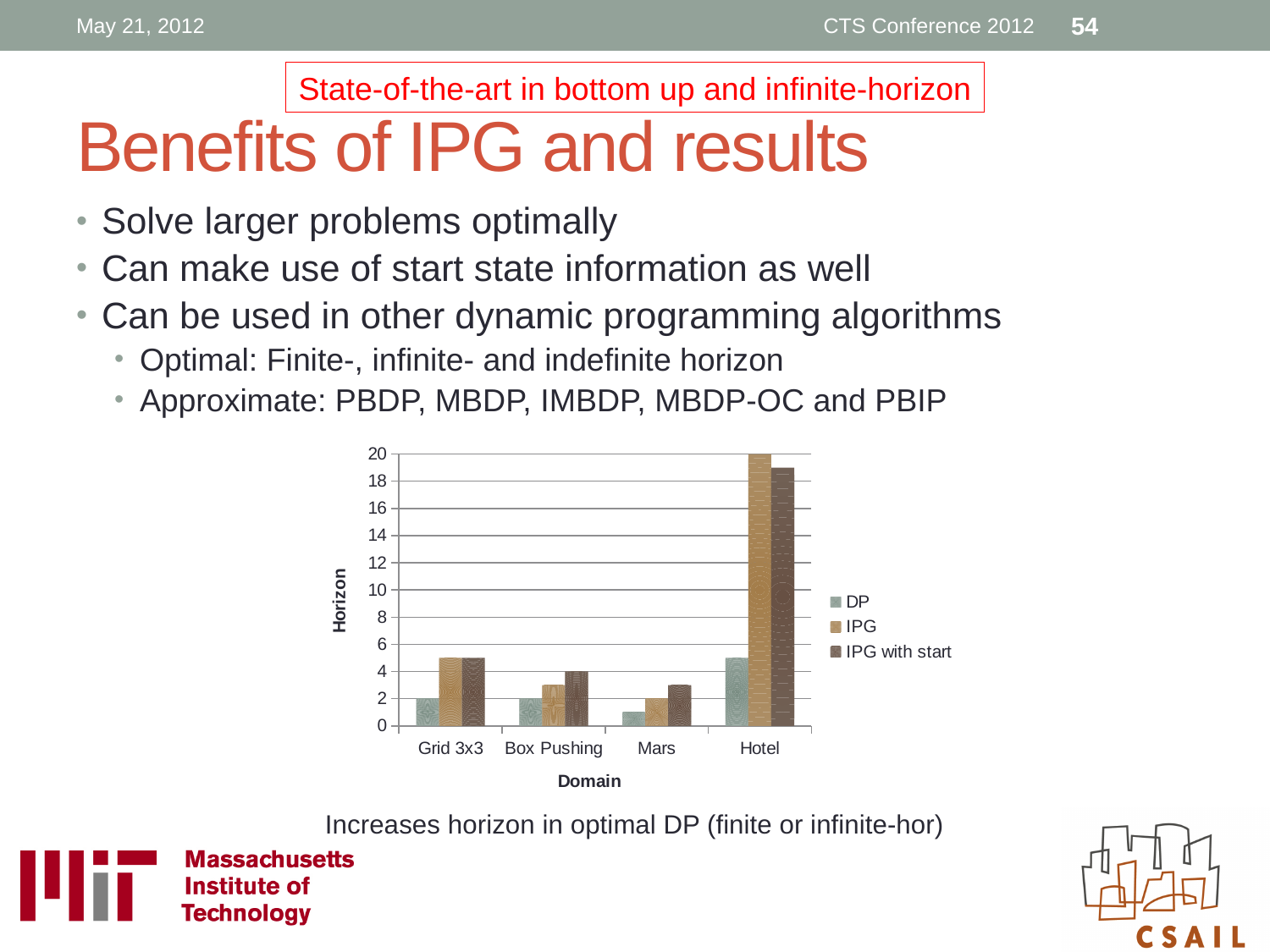
What is the IPG value for the Hotel domain? 20 What is the label of the chart's vertical axis? Horizon How many series does the chart's legend list? 3 How many domains are shown on the x axis of the chart? 4 Which domain has the highest IPG value? Hotel What kind of chart is shown on the slide? bar chart What is the DP value for the Grid 3x3 domain? 2 For the Grid 3x3 domain, which is larger: the DP value or the IPG value? IPG Is the DP value for Hotel greater or less than 10? less Which domain has the lowest IPG value? Mars Is the IPG with start value for Hotel greater or less than 18? greater What is the IPG with start value for the Box Pushing domain? 4